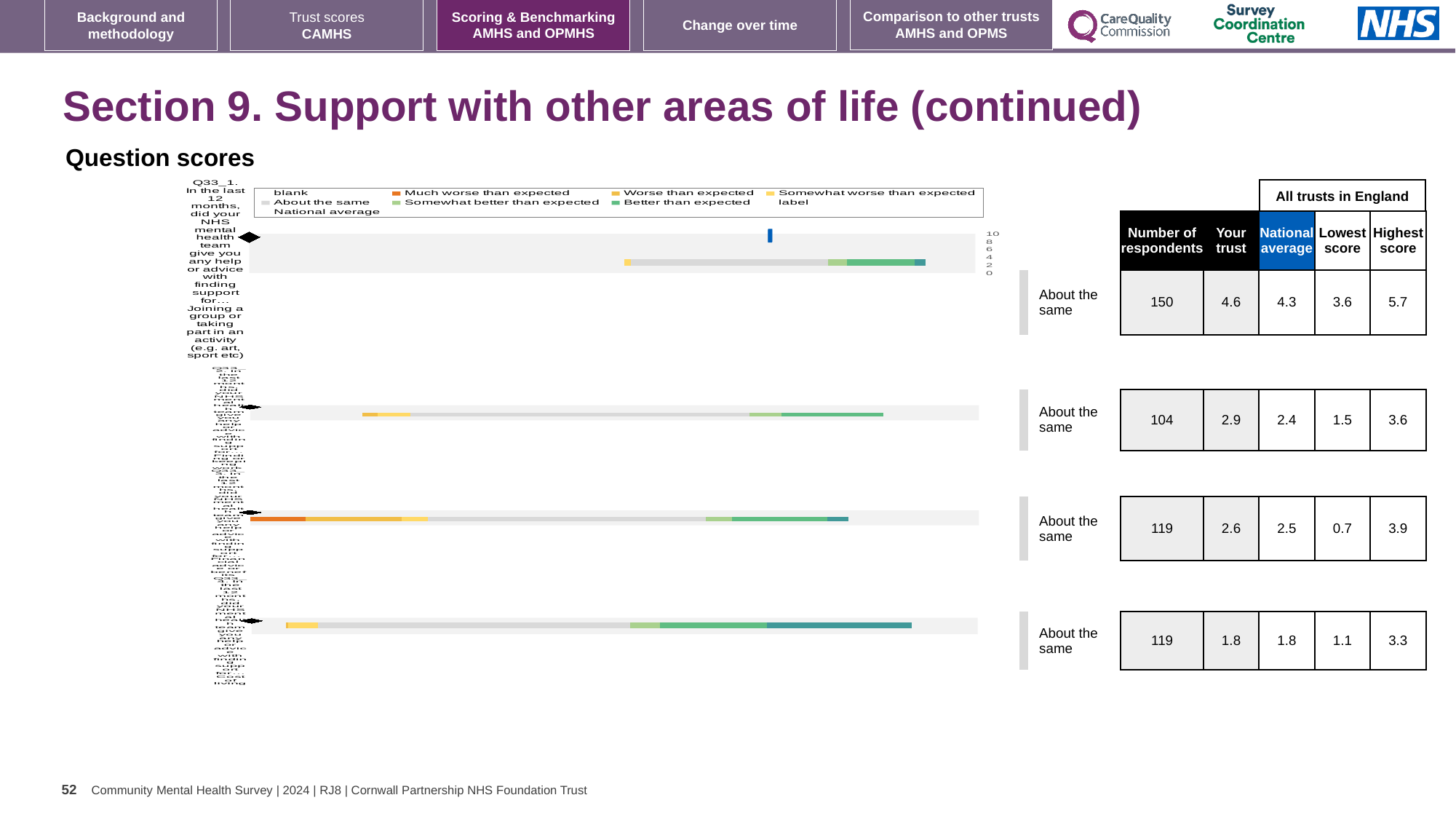
Which question row has the highest 'Your trust' score? the first row (Q33_1) What is the lowest score among all trusts in England for the third question row? 0.7 What is the national average for the first question row (Q33_1)? 4.3 Which question row has the lowest 'Your trust' score? the fourth (bottom) row What is the highest score among all trusts in England for the first question row (Q33_1)? 5.7 For the first question row (Q33_1), what is the difference between the 'Your trust' score and the national average? 0.3 How many question rows (bars) are plotted in the chart? 4 What is the number of respondents for the first question row (Q33_1, joining a group or taking part in an activity)? 150 What kind of chart is shown on the slide? bar chart What benchmark label is shown for the fourth (bottom) question row? About the same What is the 'Your trust' score for the first question row (Q33_1)? 4.6 For the first question row (Q33_1), which is larger: the 'Your trust' score or the national average? Your trust